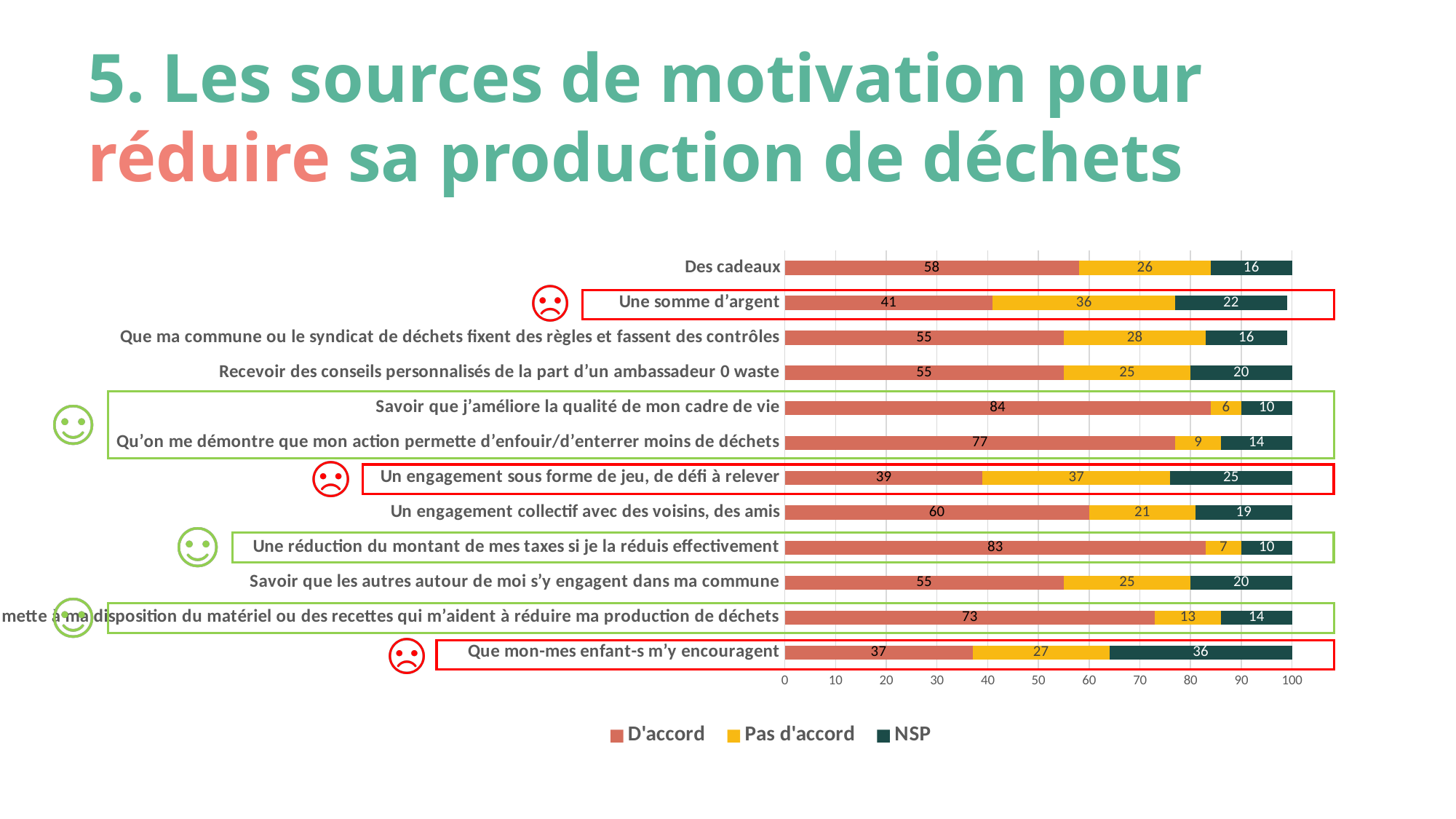
What is the total of the stacked bar for 'Une réduction du montant de mes taxes si je la réduis effectivement'? 100 Which is larger: the 'D'accord' value for 'Une somme d'argent' or for 'Un engagement collectif avec des voisins, des amis'? Un engagement collectif avec des voisins, des amis How many series does the legend list? 3 Which category has the lowest 'Pas d'accord' value? Savoir que j'améliore la qualité de mon cadre de vie What kind of chart is shown on the slide? Stacked bar chart Which category has the lowest 'D'accord' value? Que mon-mes enfant-s m'y encouragent What is the 'NSP' value for 'Que mon-mes enfant-s m'y encouragent'? 36 Which category has the highest 'D'accord' value? Savoir que j'améliore la qualité de mon cadre de vie How many categories are shown in the chart? 12 What is the 'D'accord' value for 'Des cadeaux'? 58 What is the difference between the 'D'accord' and 'Pas d'accord' values for 'Des cadeaux'? 32 What is the 'Pas d'accord' value for 'Un engagement sous forme de jeu, de défi à relever'? 37